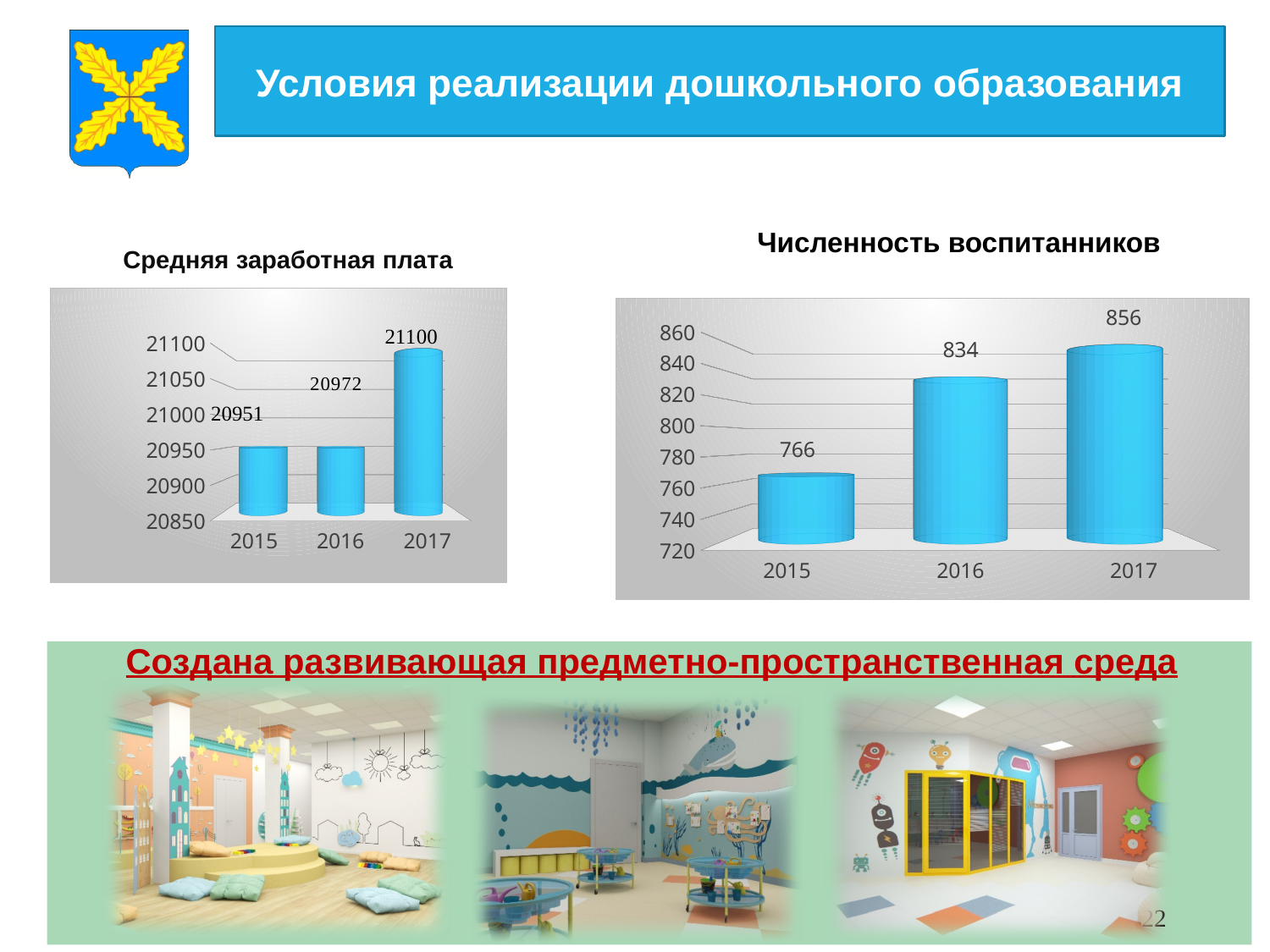
How many years are shown on the x axis of the chart titled 'Численность воспитанников'? 3 In the chart titled 'Численность воспитанников', which year has the lowest value? 2015 In the chart titled 'Численность воспитанников', what is the value for 2016? 834 In the chart titled 'Численность воспитанников', which year has the highest value? 2017 In the chart titled 'Численность воспитанников', what is the difference between the values for 2017 and 2015? 90 What kind of chart is the chart titled 'Средняя заработная плата'? bar chart In the chart titled 'Средняя заработная плата', what is the value for 2017? 21100 In the chart titled 'Средняя заработная плата', what is the difference between the values for 2017 and 2016? 128 In the chart titled 'Средняя заработная плата', what is the value for 2015? 20951 In the chart titled 'Средняя заработная плата', which is larger, the value for 2017 or the value for 2015? 2017 In the chart titled 'Численность воспитанников', is the value for 2016 greater or less than 800? greater In the chart titled 'Численность воспитанников', do the values rise or fall from 2015 to 2017? rise